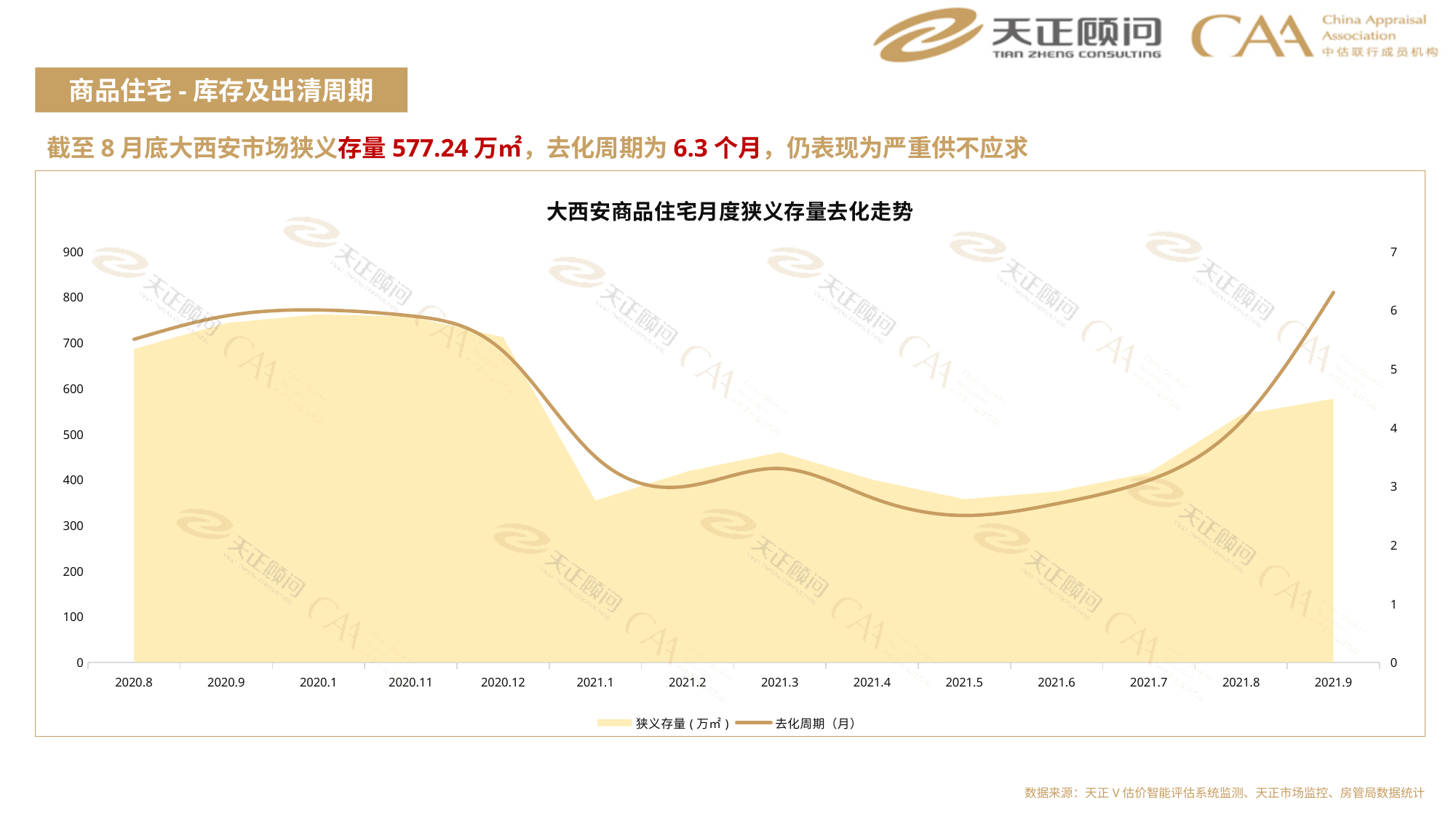
How many series does the legend list? 2 Is the value of 狭义存量 for 2021.1 greater or less than 400? less Is the value of 狭义存量 for 2020.8 greater or less than 600? greater Which is larger, the 狭义存量 value for 2020.8 or for 2021.9? 2020.8 What kind of chart is shown on the slide? A combined area and line chart Does 去化周期 rise or fall from 2021.5 to 2021.9? rise Which series is drawn as a line rather than a shaded area? 去化周期（月） In which month is 去化周期 at its lowest? 2021.5 Is the value of 去化周期 for 2021.5 greater or less than 3? less How many months are shown along the x axis? 14 What is the title of the chart? 大西安商品住宅月度狭义存量去化走势